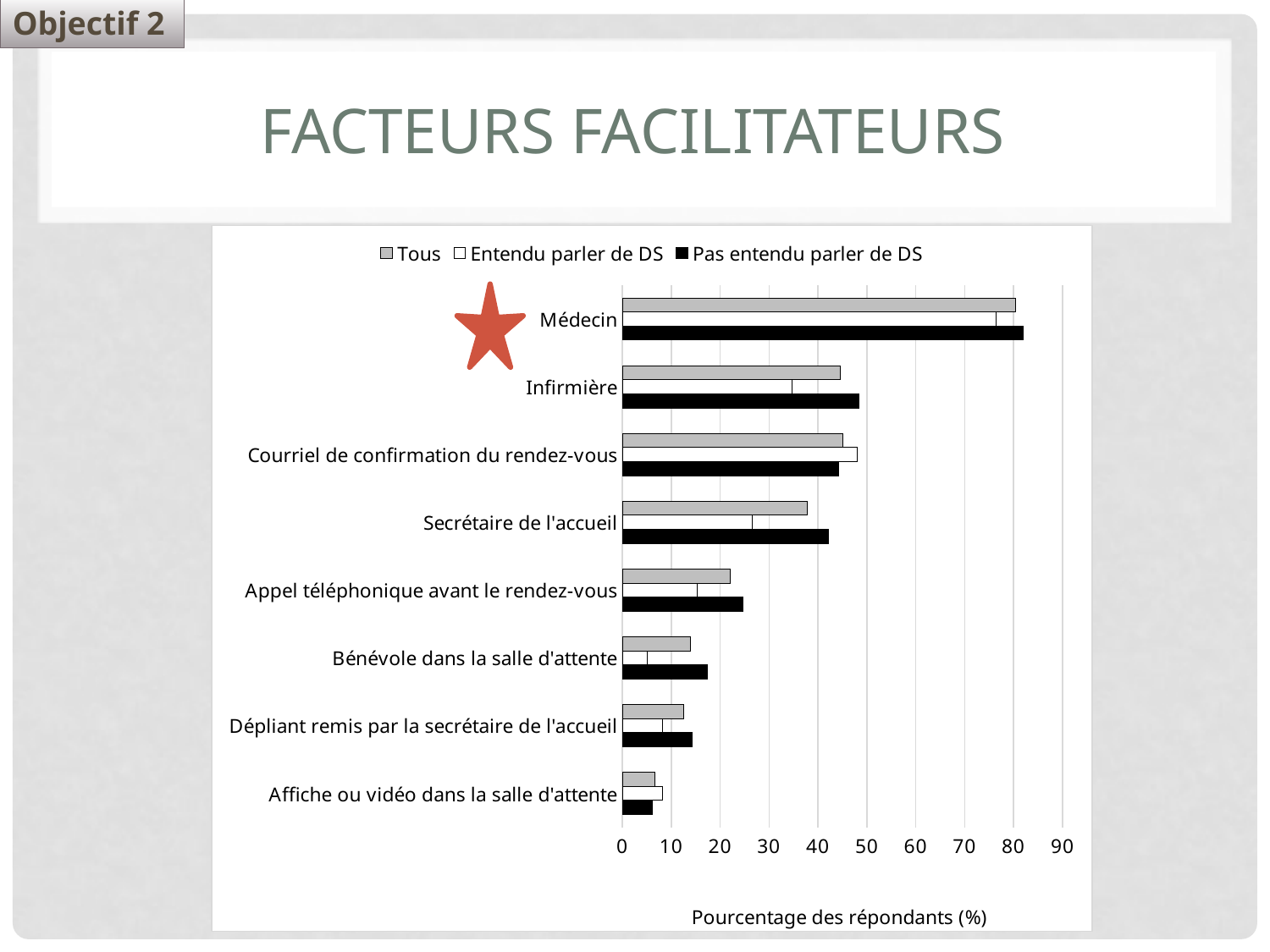
For Secrétaire de l'accueil, which series has the larger value: 'Entendu parler de DS' or 'Pas entendu parler de DS'? Pas entendu parler de DS How many series does the legend list? 3 Which category has the lowest value for the 'Tous' series? Affiche ou vidéo dans la salle d'attente Which category has a larger 'Tous' value: Infirmière or Appel téléphonique avant le rendez-vous? Infirmière What is the label of the x axis? Pourcentage des répondants (%) Is the 'Entendu parler de DS' value for Infirmière greater or less than 40? less Is the 'Pas entendu parler de DS' value for Médecin greater or less than 80? greater Is the 'Tous' value for Appel téléphonique avant le rendez-vous greater or less than 20? greater Which category has the highest value for the 'Tous' series? Médecin What kind of chart is shown on the slide? bar chart How many categories are plotted on the y axis? 8